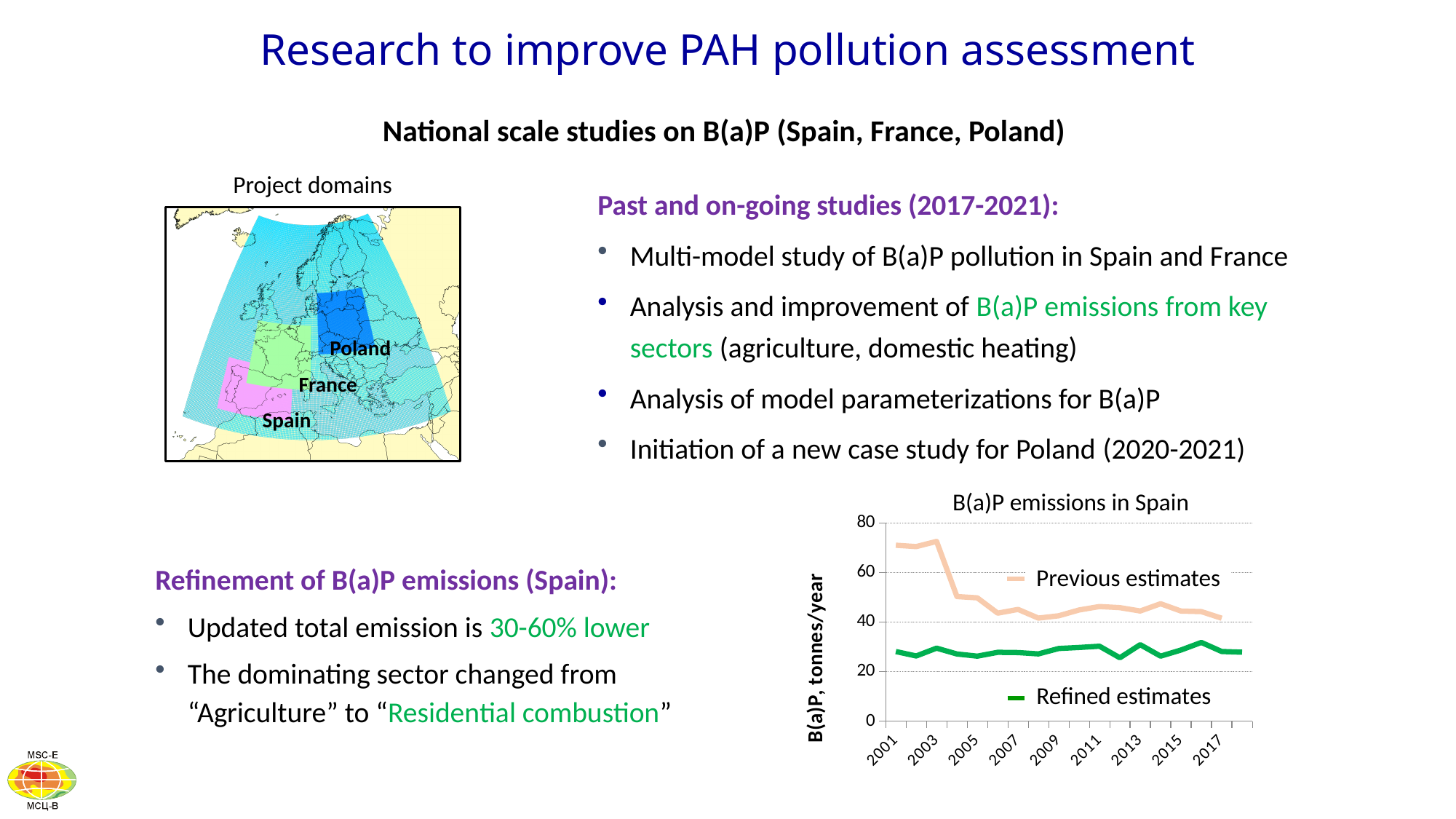
In the 'B(a)P emissions in Spain' chart, is the value for Refined estimates in 2015 greater or less than 20? greater What is the y-axis label of the 'B(a)P emissions in Spain' chart? B(a)P, tonnes/year In the 'B(a)P emissions in Spain' chart, is the value for Previous estimates in 2017 greater or less than 60? less In the 'B(a)P emissions in Spain' chart, is the value for Previous estimates in 2001 greater or less than 60? greater In the 'B(a)P emissions in Spain' chart, which series is the highest in 2003? Previous estimates What is the title of the chart on the slide? B(a)P emissions in Spain What kind of chart is the 'B(a)P emissions in Spain' chart? line chart In the 'B(a)P emissions in Spain' chart, which series has the higher value in 2005, Previous estimates or Refined estimates? Previous estimates In the 'B(a)P emissions in Spain' chart, which series has the lower value in 2011, Previous estimates or Refined estimates? Refined estimates How many series does the legend of the 'B(a)P emissions in Spain' chart list? 2 In the 'B(a)P emissions in Spain' chart, do the Previous estimates values generally rise or fall from 2001 to 2017? fall